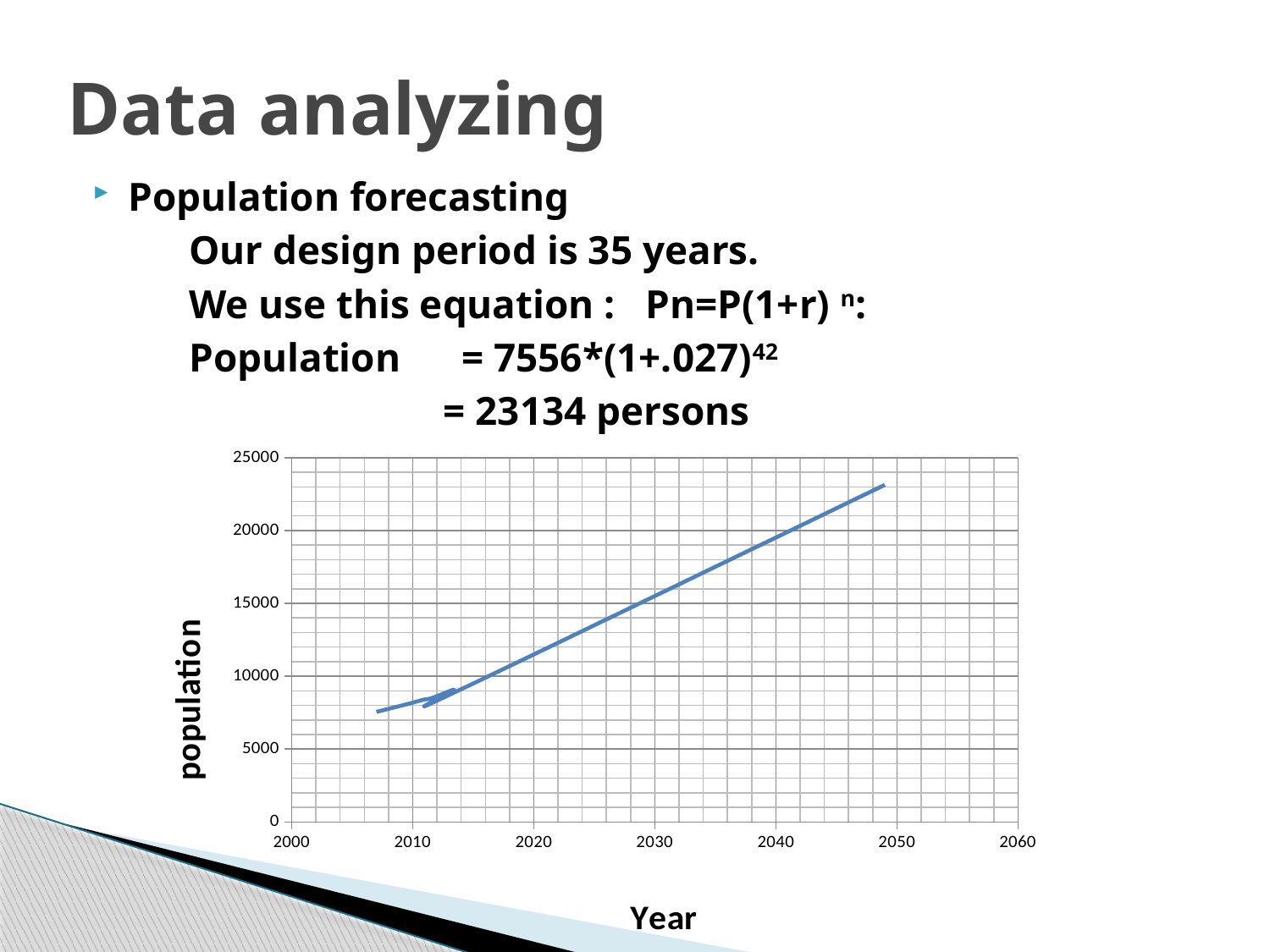
What kind of chart is shown on the slide? line chart What is the highest value shown on the vertical axis of the chart? 25000 Is the population value plotted at 2010 greater or less than 10000? less Which is larger, the population plotted at 2010 or the population plotted at 2040? 2040 Is the population value plotted at 2020 greater or less than 10000? greater What is the label of the horizontal axis of the chart? Year Is the highest population value plotted on the chart greater or less than 20000? greater What is the label of the vertical axis of the chart? population Does the population line rise or fall as the year increases along the x axis? rise